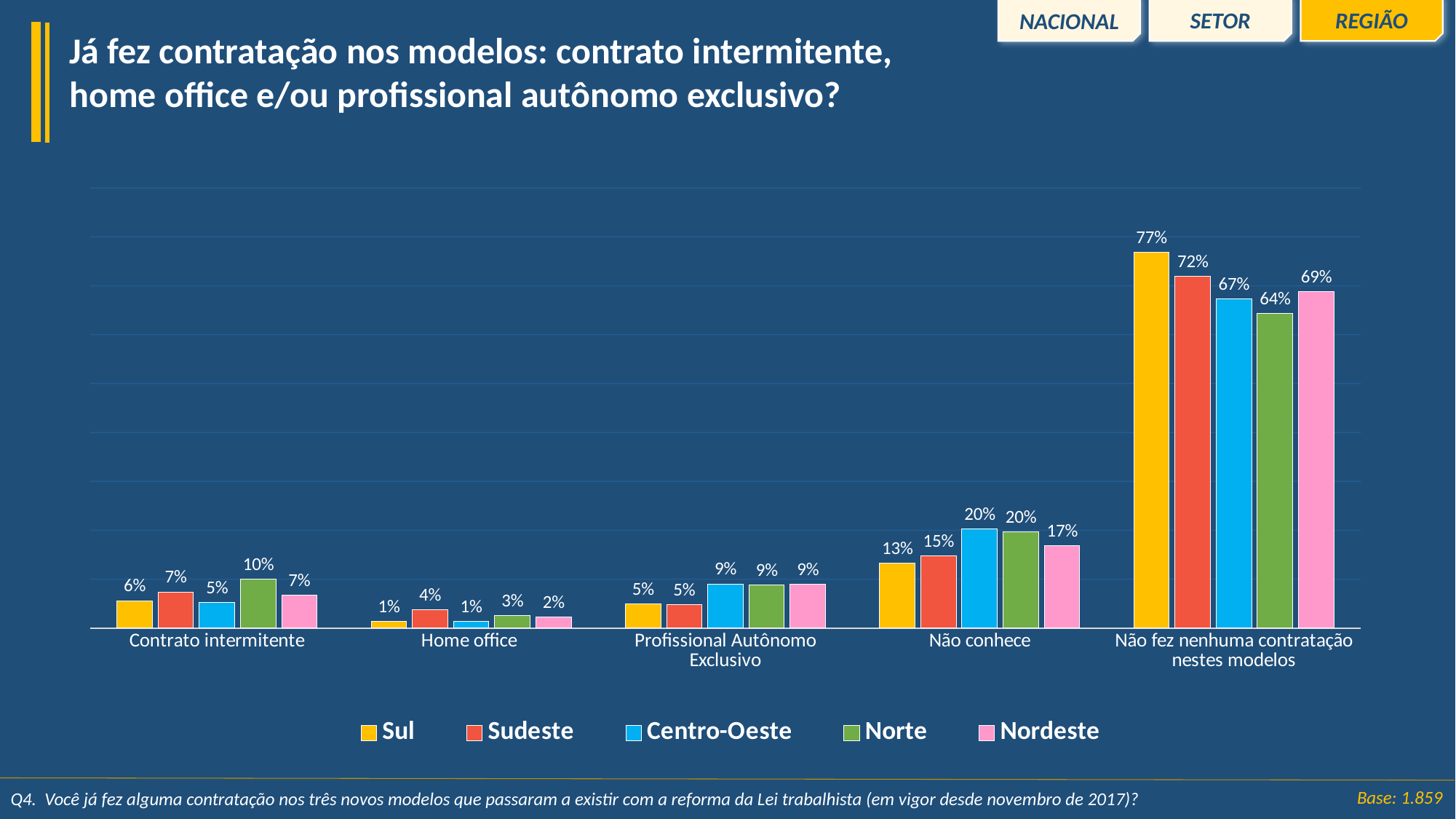
What is the value for Sudeste in the Home office category? 4% What is the difference between the Sul and Norte values in the Não fez nenhuma contratação nestes modelos category? 13% How many series does the legend list? 5 What is the value for Nordeste in the Não conhece category? 17% How many categories are shown on the x axis? 5 What is the value for Norte in the Contrato intermitente category? 10% What is the value for Centro-Oeste in the Profissional Autônomo Exclusivo category? 9% Which colour represents the Centro-Oeste series in the legend? Blue Which region has the lowest value in the Não fez nenhuma contratação nestes modelos category? Norte What kind of chart is shown on the slide? Bar chart In the Não conhece category, which is larger: the value for Sudeste or the value for Sul? Sudeste Which region has the highest value in the Não fez nenhuma contratação nestes modelos category? Sul